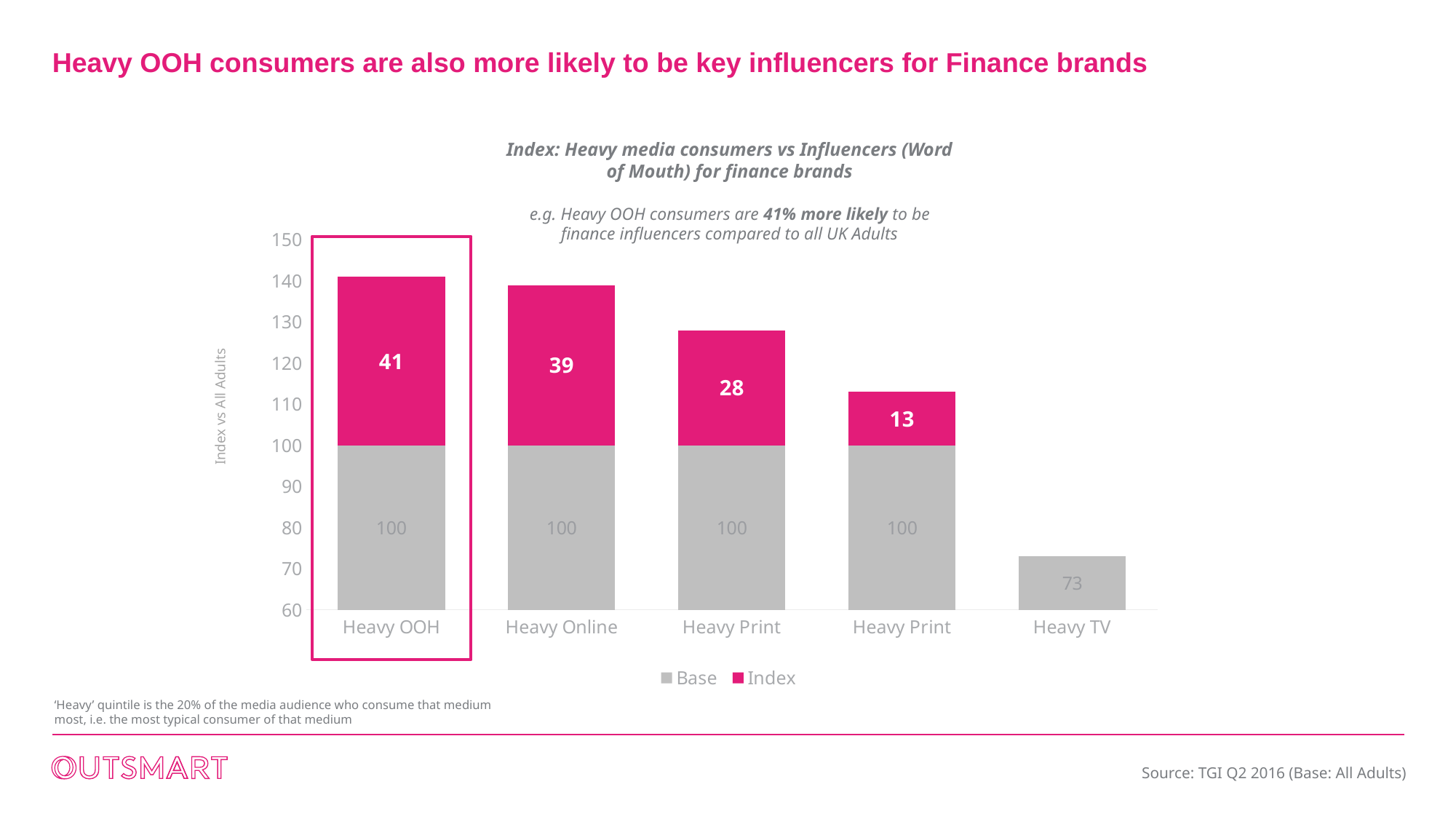
What is the Index value shown for Heavy OOH? 41 What is the Index value shown on the third bar from the left? 28 What is the difference between the Index values for Heavy OOH and Heavy Online? 2 What is the Index value shown for Heavy Online? 39 What is the Base value shown for Heavy TV? 73 Do the total bar heights rise or fall from left to right across the x axis? fall Which has the larger Index value, Heavy OOH or Heavy Online? Heavy OOH What is the total height of the stacked bar for Heavy OOH (Base plus Index)? 141 What is the total height of the stacked bar for Heavy Online (Base plus Index)? 139 How many series does the legend list? 2 Which category has the highest Index value? Heavy OOH How many categories are shown on the x axis? 5